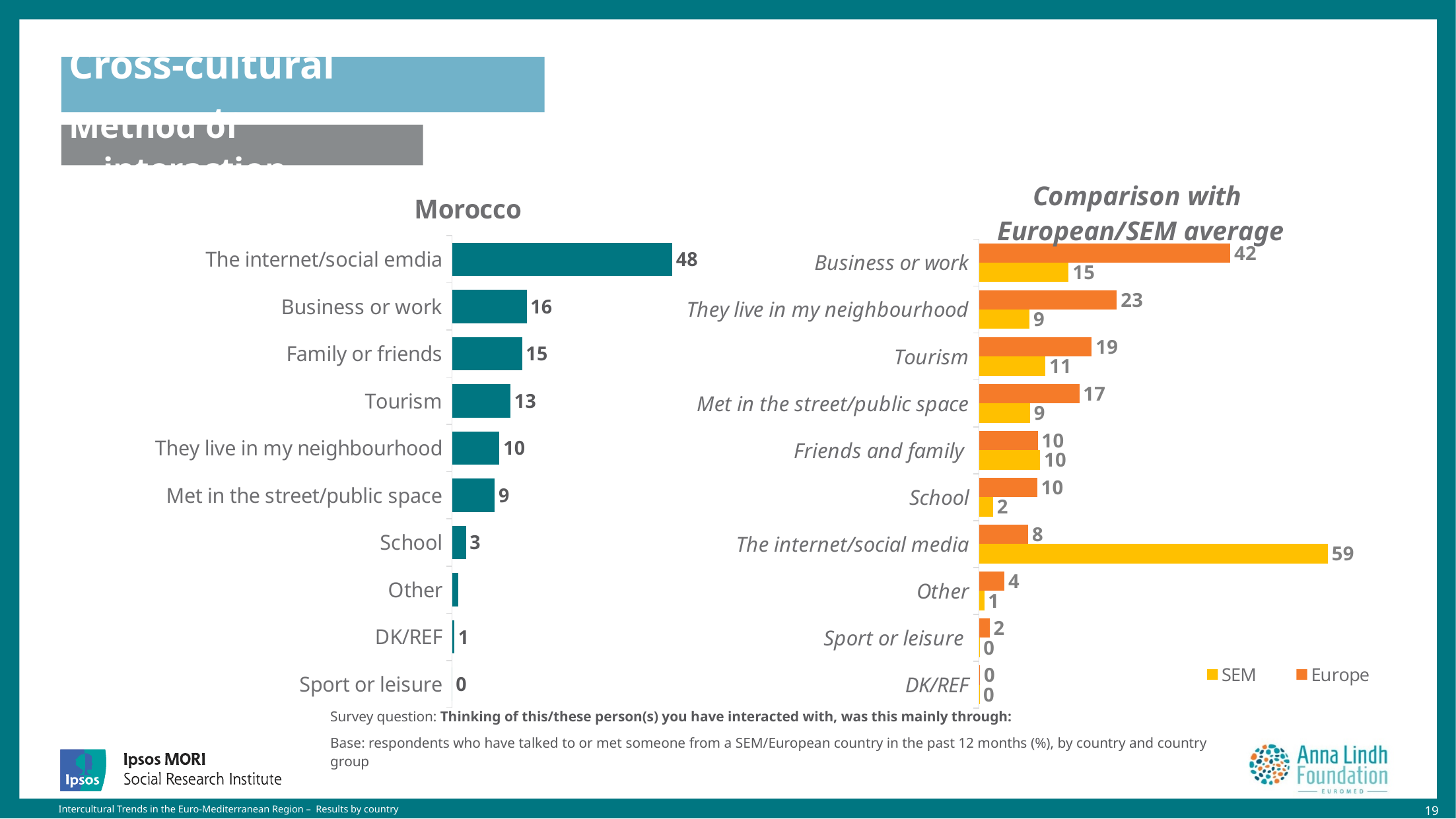
In the Comparison with European/SEM average chart, which colour represents the SEM series? Yellow How many categories are shown in the Morocco chart? 10 In the Morocco chart, which is larger: They live in my neighbourhood or Met in the street/public space? They live in my neighbourhood In the Morocco chart, what is the difference between Family or friends and Tourism? 2 In the Comparison with European/SEM average chart, what is the SEM value for The internet/social media? 59 In the Morocco chart, what is the value for Business or work? 16 In the Comparison with European/SEM average chart, what is the Europe value for Business or work? 42 How many series does the legend of the Comparison with European/SEM average chart list? 2 In the Comparison with European/SEM average chart, what is the difference between the Europe and SEM values for They live in my neighbourhood? 14 In the Comparison with European/SEM average chart, which series has the higher value for Tourism? Europe In the Morocco chart, which category has the highest value? The internet/social emdia What type of chart is the Morocco chart? Bar chart